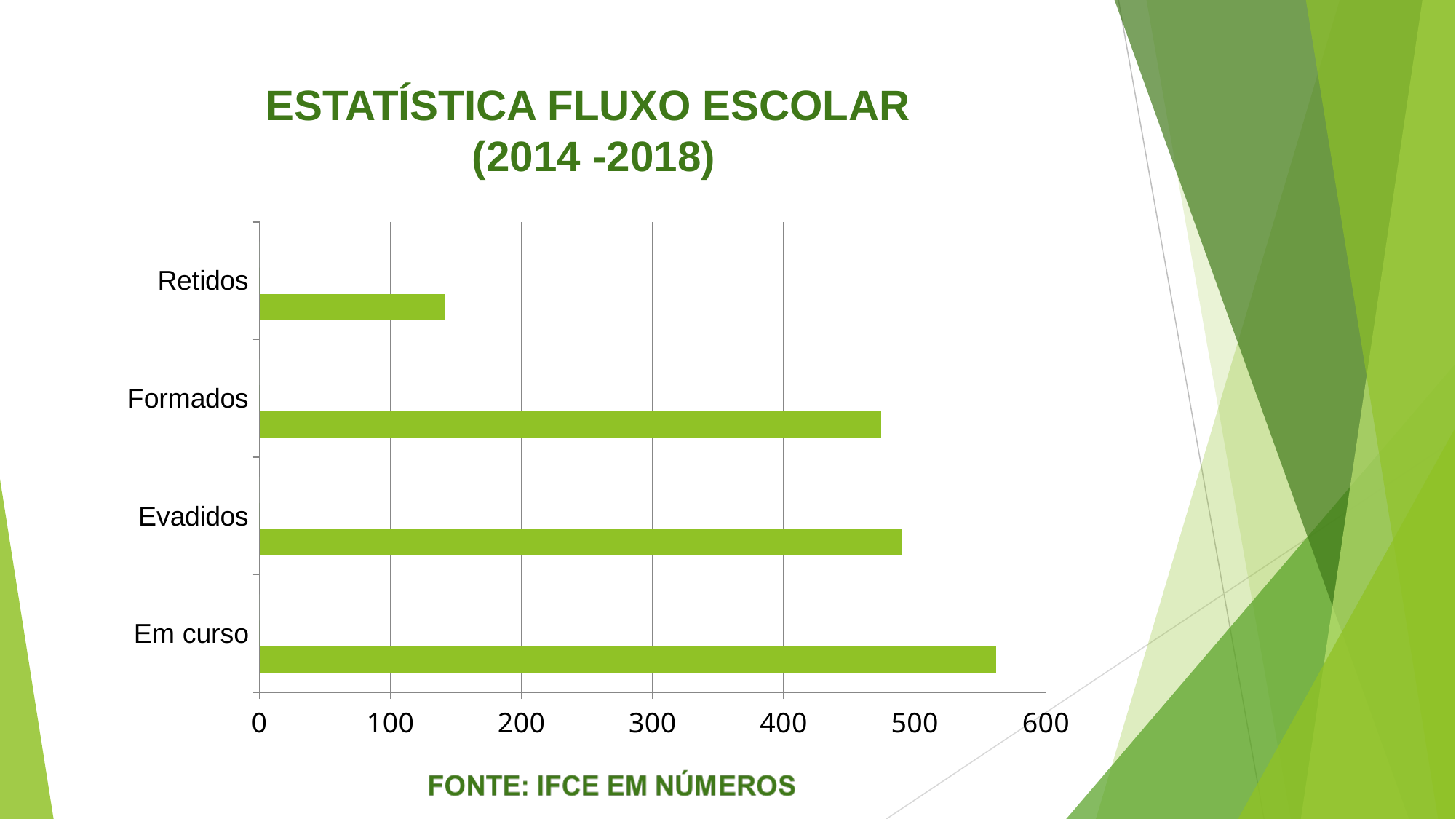
Is the value for Evadidos greater or less than 500? less What is the title of the chart? ESTATÍSTICA FLUXO ESCOLAR (2014 -2018) How many categories are plotted in the chart? 4 Is the value for Em curso greater or less than 500? greater Which category has the lowest value? Retidos What kind of chart is shown on the slide? bar chart Which category has the highest value? Em curso Is the value for Retidos greater or less than 100? greater Which is larger, the value for Em curso or the value for Retidos? Em curso What source is cited below the chart? IFCE EM NÚMEROS